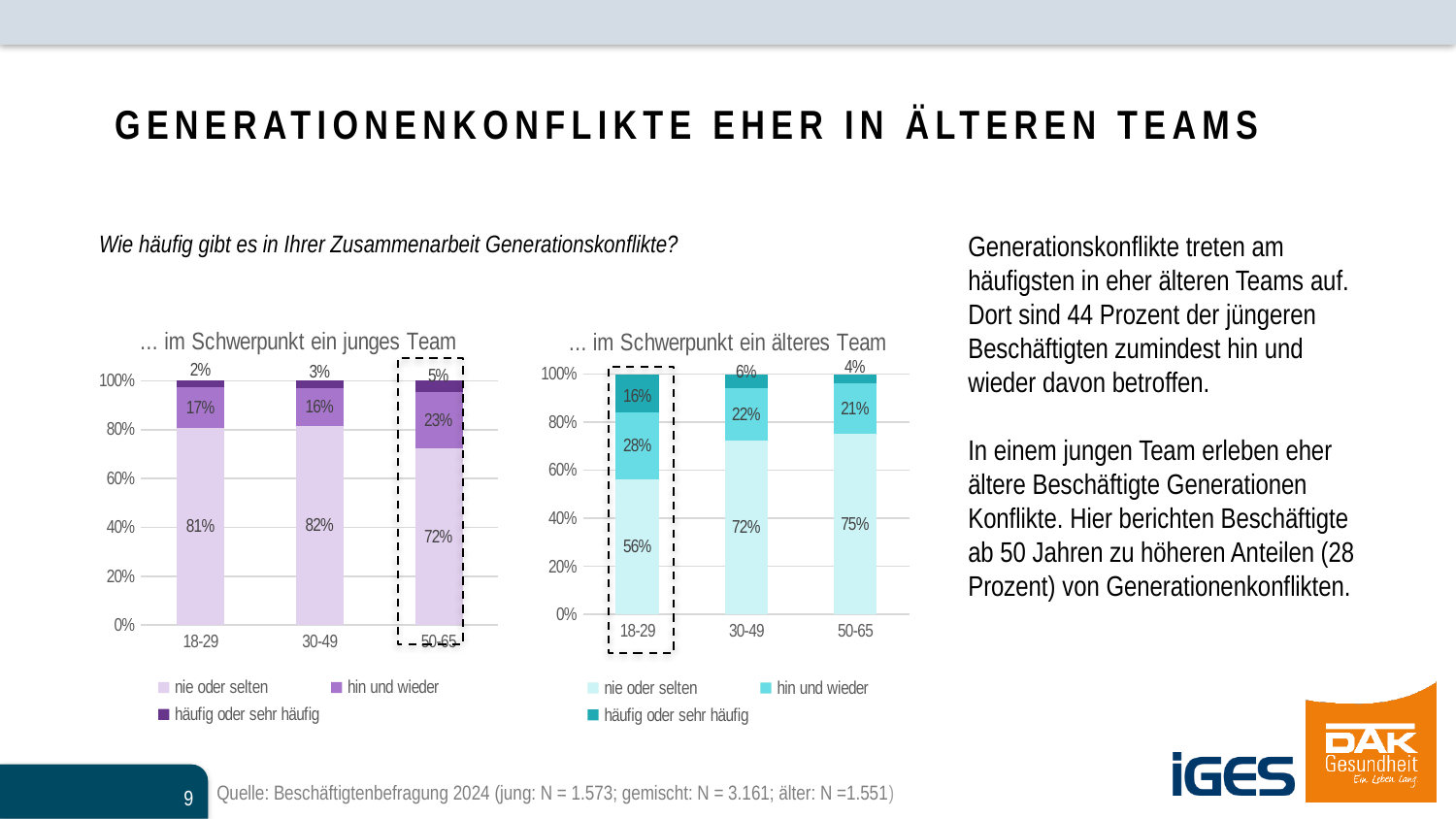
In the chart '… im Schwerpunkt ein junges Team', what is the value for 'nie oder selten' in the 18-29 age group? 81% In the chart '… im Schwerpunkt ein älteres Team', what is the difference between the 'hin und wieder' values for 18-29 and 50-65? 7% In the chart '… im Schwerpunkt ein älteres Team', is the 'häufig oder sehr häufig' value larger for 18-29 or for 30-49? 18-29 How many series does the legend of the chart '… im Schwerpunkt ein älteres Team' list? 3 In the chart '… im Schwerpunkt ein junges Team', what is the value for 'hin und wieder' in the 50-65 age group? 23% What kind of chart is '… im Schwerpunkt ein junges Team'? Stacked bar chart In the chart '… im Schwerpunkt ein älteres Team', what is the value for 'nie oder selten' in the 50-65 age group? 75% In the chart '… im Schwerpunkt ein älteres Team', what is the value for 'häufig oder sehr häufig' in the 18-29 age group? 16% In the chart '… im Schwerpunkt ein junges Team', what is the difference between the 'nie oder selten' values for 30-49 and 50-65? 10% In the chart '… im Schwerpunkt ein junges Team', which age group has the highest value for 'hin und wieder'? 50-65 In the chart '… im Schwerpunkt ein älteres Team', which age group has the lowest value for 'nie oder selten'? 18-29 How many age groups are shown in the chart '… im Schwerpunkt ein junges Team'? 3